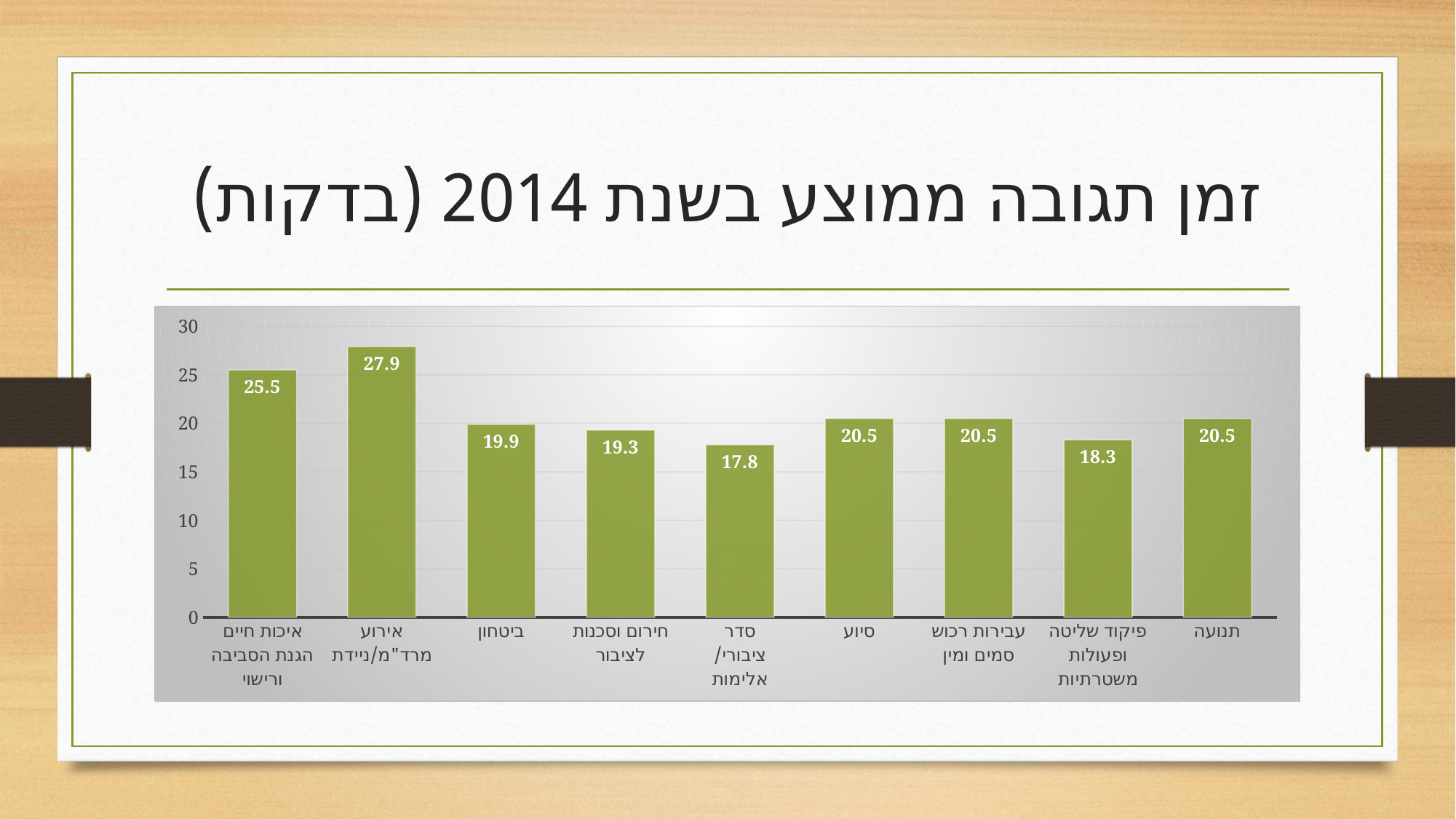
Which is larger, the value for ביטחון or the value for חירום וסכנות לציבור? ביטחון Which category has the lowest value? סדר ציבורי/אלימות What is the value for חירום וסכנות לציבור? 19.3 What is the value for סדר ציבורי/אלימות? 17.8 What kind of chart is shown on the slide? bar chart Which category has the highest value? אירוע מרד"מ/ניידת What is the difference between the values for אירוע מרד"מ/ניידת and איכות חיים הגנת הסביבה ורישוי? 2.4 How many categories are shown in the chart? 9 What is the value for ביטחון? 19.9 Is the value for איכות חיים הגנת הסביבה ורישוי greater or less than 25? greater What is the title of the slide? זמן תגובה ממוצע בשנת 2014 (בדקות) What is the value for פיקוד שליטה ופעולות משטרתיות? 18.3